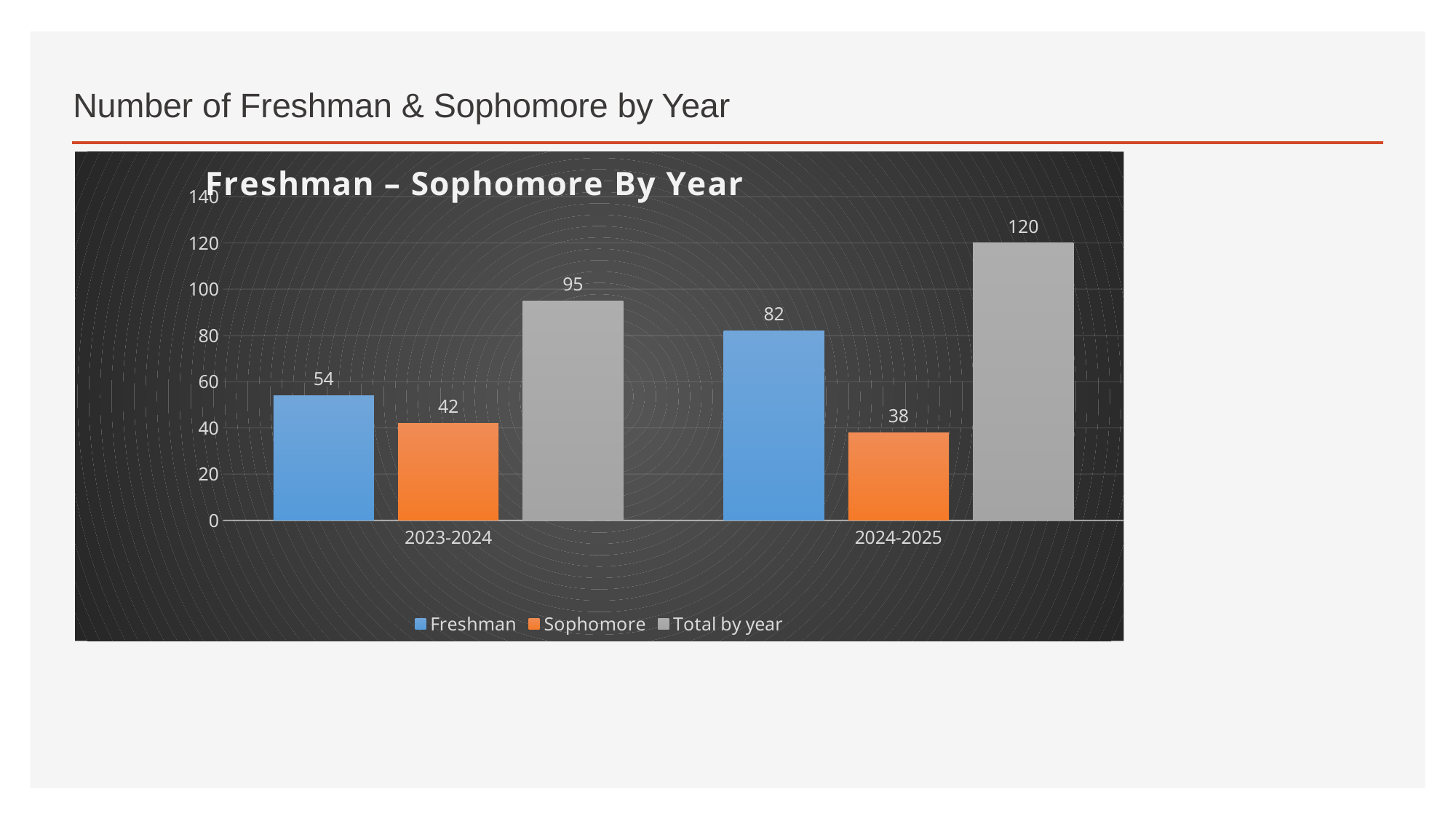
How many series does the legend list? 3 Which year has the lower Sophomore value? 2024-2025 What is the Total by year value for 2024-2025? 120 How many year categories are shown on the x axis? 2 Which year has the higher Freshman value? 2024-2025 What is the Freshman value for 2023-2024? 54 Which is larger, the Freshman value for 2023-2024 or the Sophomore value for 2023-2024? Freshman What is the title of the chart? Freshman – Sophomore By Year What is the difference between the Freshman values for 2024-2025 and 2023-2024? 28 What kind of chart is shown on the slide? Bar chart What is the Sophomore value for 2024-2025? 38 What is the difference between the Total by year values for 2024-2025 and 2023-2024? 25